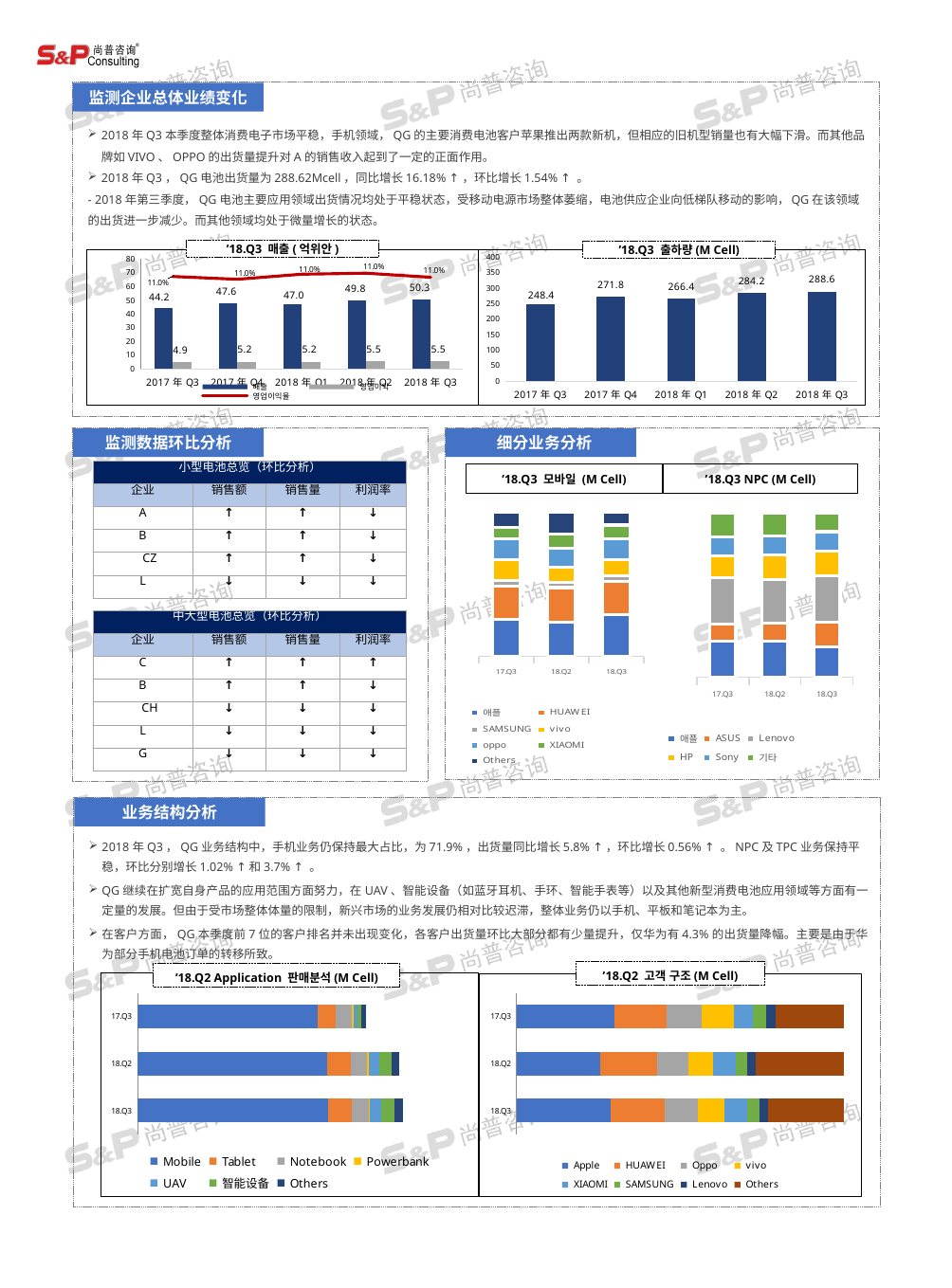
In the '18.Q3 출하량 (M Cell) chart, what is the difference between the values for 2018年Q2 and 2018年Q1? 17.8 In the '18.Q3 매출 (억위안) chart, what is the value of the tallest bar for 2018年Q3? 50.3 In the '18.Q3 출하량 (M Cell) chart, which category has the lowest value? 2017年Q3 In the '18.Q3 출하량 (M Cell) chart, how many categories are shown on the x axis? 5 In the '18.Q3 매출 (억위안) chart, what is the value of the smaller bar for 2017年Q3? 4.9 How many series does the legend of the '18.Q2 고객 구조 (M Cell) chart list? 8 What kind of chart is the '18.Q2 Application 판매분석 (M Cell) chart? Stacked bar chart In the '18.Q3 매출 (억위안) chart, what is the difference between the tall bars for 2018年Q3 and 2017年Q3? 6.1 How many series does the legend of the '18.Q3 모바일 (M Cell) chart list? 7 In the '18.Q3 출하량 (M Cell) chart, what is the value for 2018年Q3? 288.6 In the '18.Q3 출하량 (M Cell) chart, is the value for 2017年Q4 greater or less than 250? greater In the '18.Q3 매출 (억위안) chart, which is larger among the tall bars: 2017年Q4 or 2018年Q1? 2017年Q4